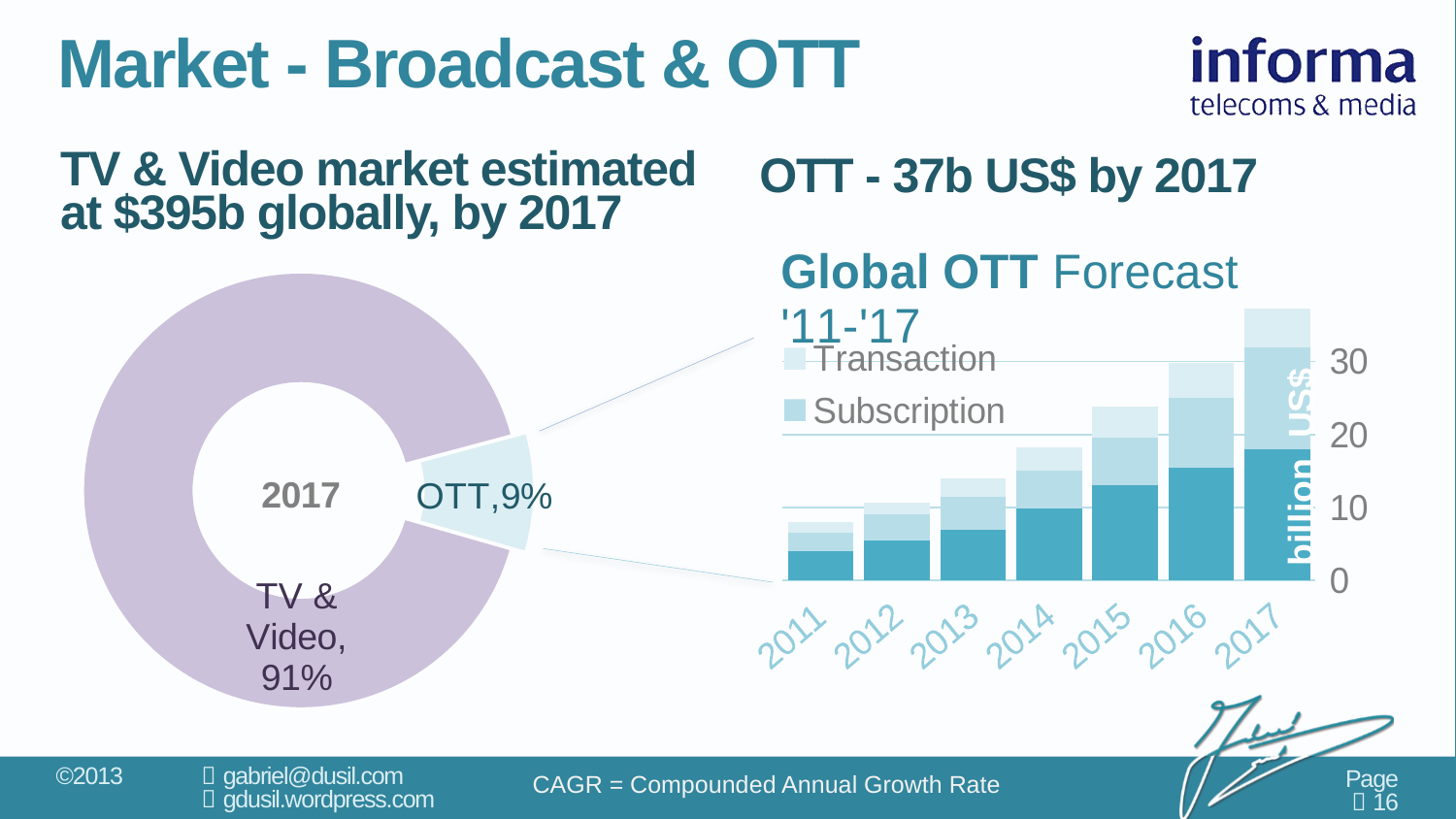
On the donut chart on the left, what share of the 2017 market is OTT? 9% On the donut chart on the left, which segment is larger, OTT or TV & Video? TV & Video What kind of chart is the Global OTT Forecast chart on the right? Stacked bar chart In the Global OTT Forecast chart, is the total value for 2011 greater or less than 10? less On the donut chart on the left, what share of the 2017 market is TV & Video? 91% How many segments does the donut chart on the left have? 2 In the Global OTT Forecast chart, do the total bar values rise or fall from 2011 to 2017? Rise In the Global OTT Forecast chart, which year has the lowest total bar? 2011 In the Global OTT Forecast chart, is the total value for 2017 greater or less than 30? greater How many years are shown on the x axis of the Global OTT Forecast chart? 7 In the Global OTT Forecast chart, which year has the highest total bar? 2017